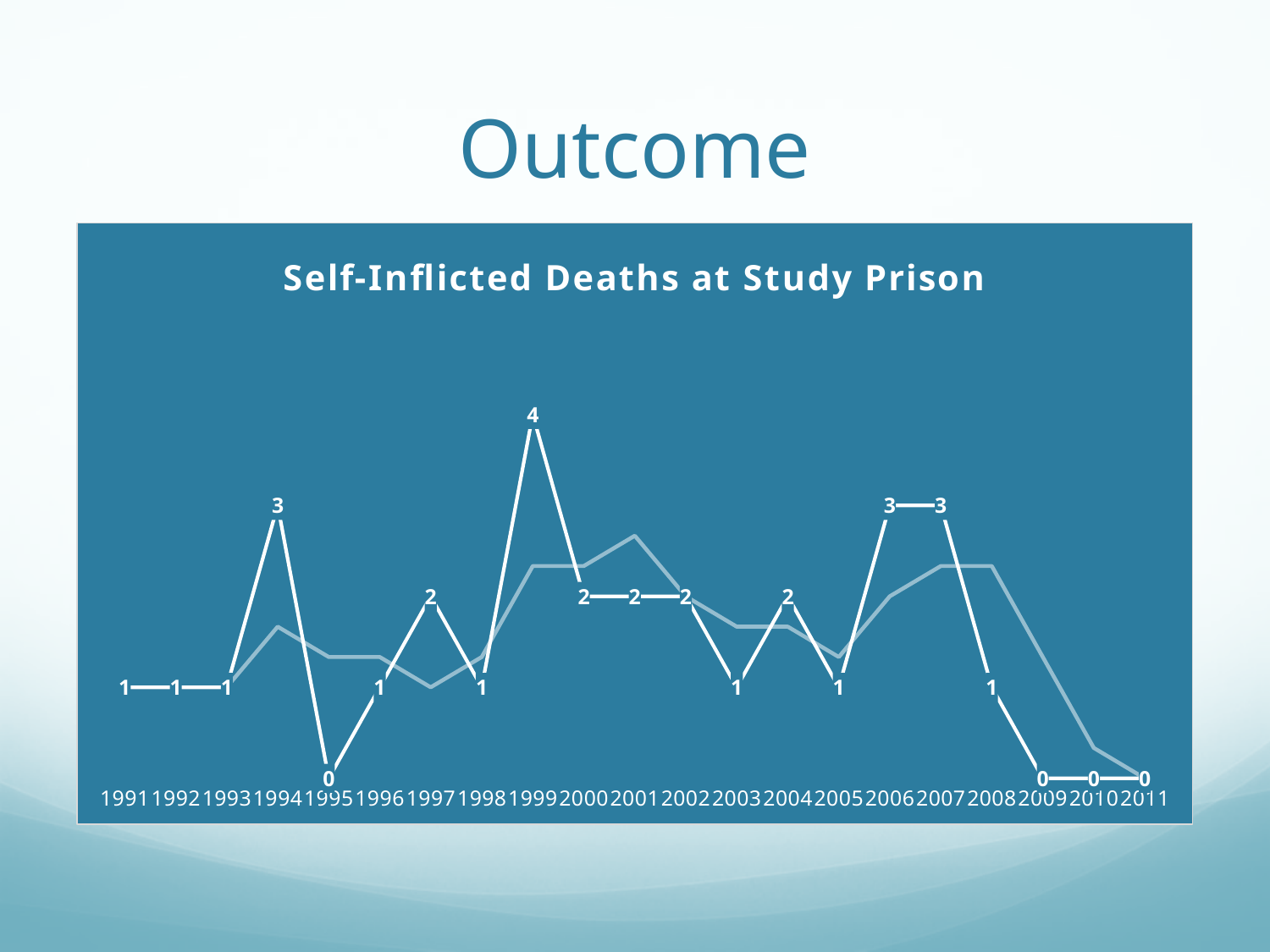
What type of chart is shown on the slide? line chart What is the difference between the values for 1994 and 1995? 3 What is the value shown for 1994? 3 How many self-inflicted deaths are shown for 1999? 4 Which year has the highest number of self-inflicted deaths? 1999 Do the values rise or fall from 2007 to 2009? fall What is the value shown for 2010? 0 Which is larger, the value for 2006 or the value for 2008? 2006 How many years are shown on the x axis? 21 What is the value shown for 2005? 1 What is the difference between the values for 1999 and 2000? 2 What is the title of the chart? Self-Inflicted Deaths at Study Prison